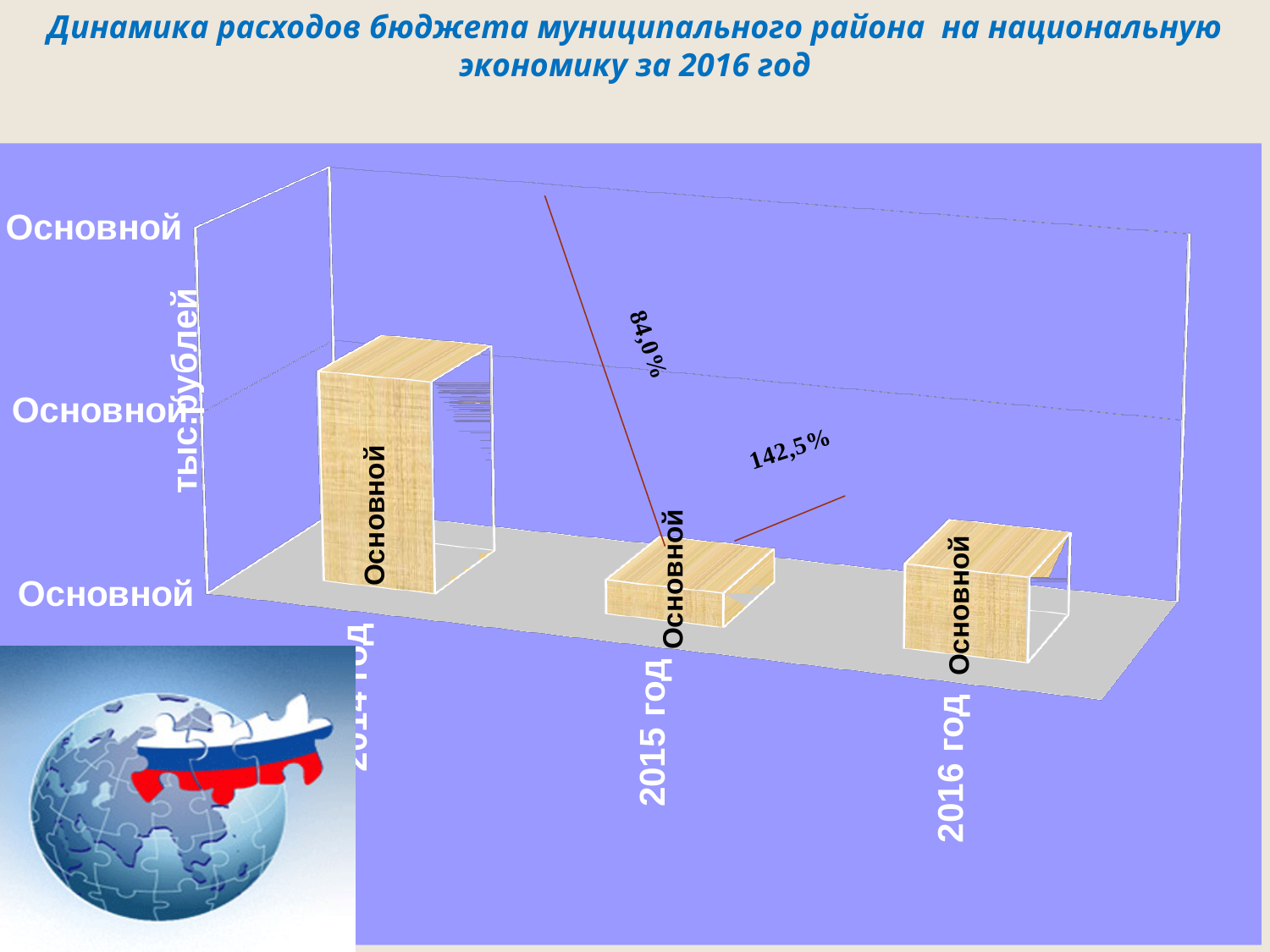
Does the value rise or fall from 2015 год to 2016 год? rise Which bar is taller, 2014 год or 2016 год? 2014 год Which year has the highest bar on the chart? 2014 год What percentage annotation is written next to the 2016 год bar? 142,5% Which bar is taller, 2015 год or 2016 год? 2016 год Does the value rise or fall from 2014 год to 2015 год? fall Which year has the lowest bar on the chart? 2015 год What kind of chart is shown on the slide? bar chart How many categories (years) are plotted on the chart? 3 What unit label is written along the vertical axis of the chart? тыс.рублей